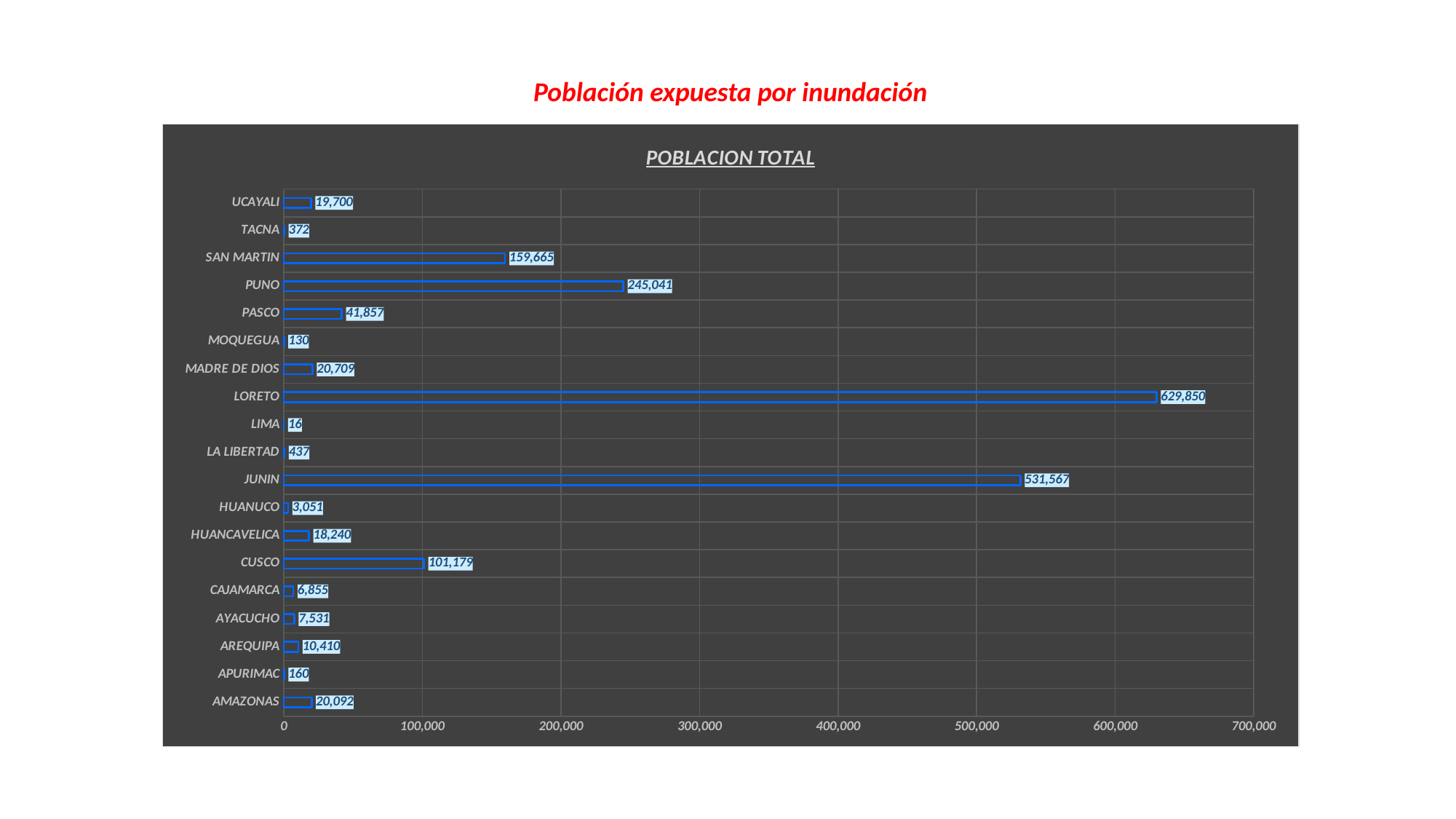
What is the difference between the values for LORETO and JUNIN? 98,283 Is the value for JUNIN greater or less than 500,000? greater Which category has the lowest value? LIMA What is the value for LORETO? 629,850 What is the value for HUANCAVELICA? 18,240 What kind of chart is shown on the slide? bar chart What is the value for PUNO? 245,041 What is the difference between the values for PUNO and SAN MARTIN? 85,376 Which category has the highest value? LORETO Which is larger, the value for CUSCO or the value for PASCO? CUSCO How many categories are shown on the chart? 19 What is the title of the chart? POBLACION TOTAL